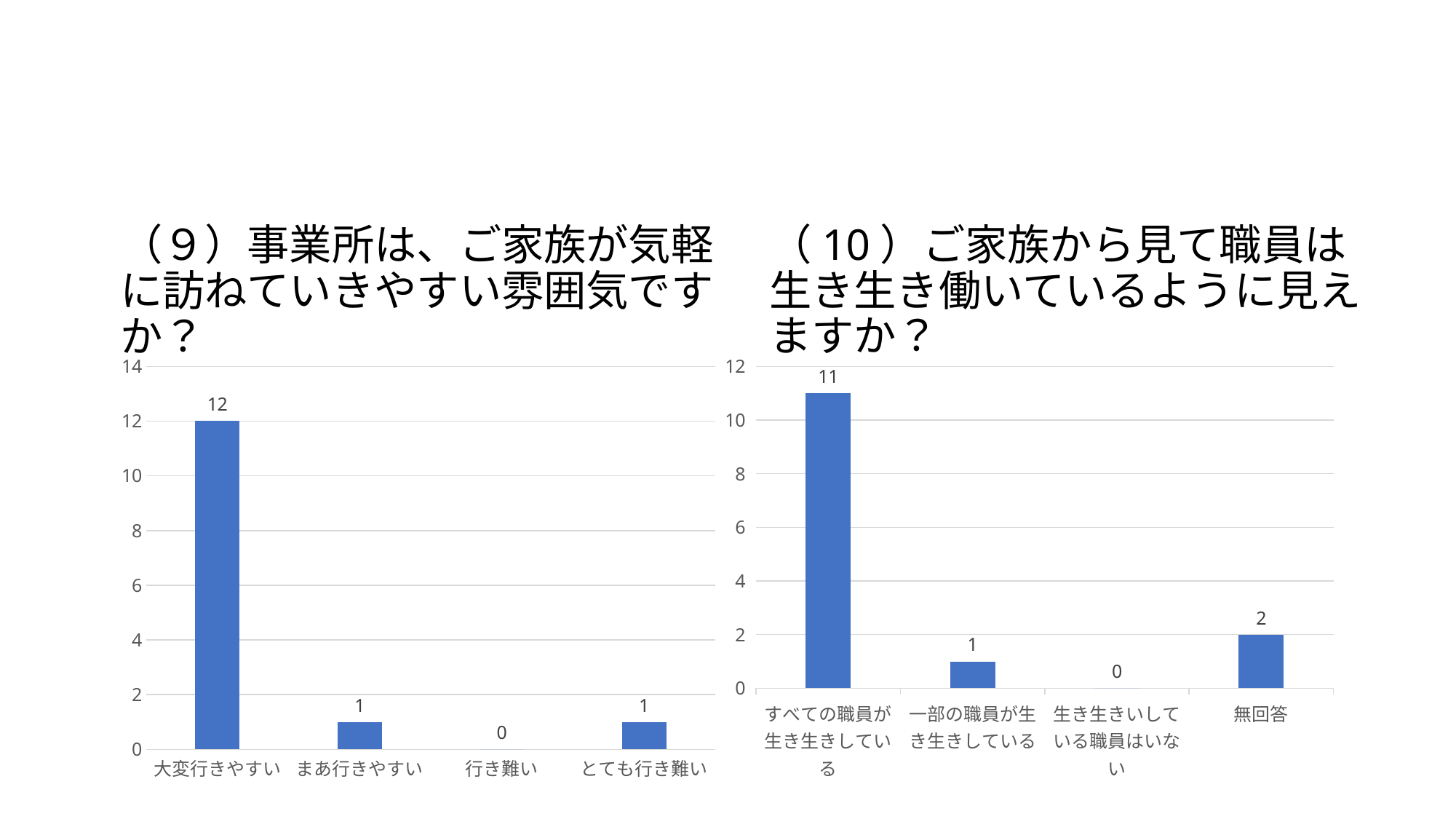
In the left chart (9), what is the difference between 大変行きやすい and まあ行きやすい? 11 In the right chart (10), which is larger: 無回答 or 一部の職員が生き生きしている? 無回答 In the left chart (9), how many categories are shown on the x axis? 4 In the right chart (10), is the value for すべての職員が生き生きしている greater or less than 10? greater In the left chart (9), which category has the highest value? 大変行きやすい In the left chart (9), what is the value for 大変行きやすい? 12 In the right chart (10), what is the value for 無回答? 2 In the left chart (9), what kind of chart is shown? bar chart In the right chart (10), what is the total of all four bars? 14 In the left chart (9), what is the value for 行き難い? 0 In the right chart (10), which category has the lowest value? 生き生きいしている職員はいない In the right chart (10), what is the value for 一部の職員が生き生きしている? 1